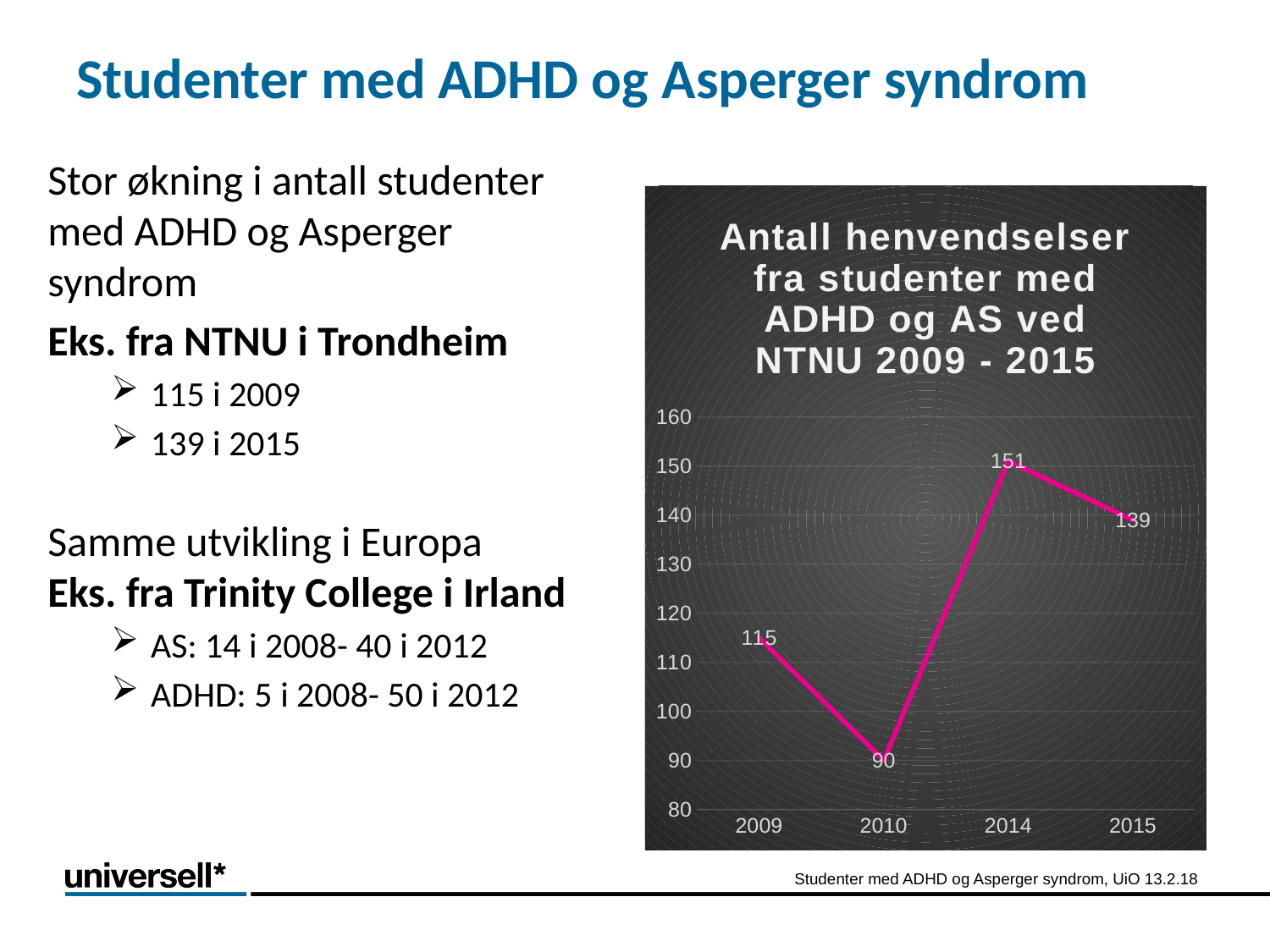
What is the value for 2010 in the chart? 90 What kind of chart is shown on the slide? Line chart What is the difference between the values for 2009 and 2010? 25 What is the value for 2014 in the chart? 151 What is the value for 2015 in the chart? 139 Which year has the lowest value in the chart? 2010 Which year has the highest value in the chart? 2014 Which is larger, the value for 2009 or the value for 2015? 2015 What is the value for 2009 in the chart? 115 What is the difference between the values for 2014 and 2015? 12 What is the title of the chart? Antall henvendselser fra studenter med ADHD og AS ved NTNU 2009 - 2015 How many data points are plotted in the chart? 4